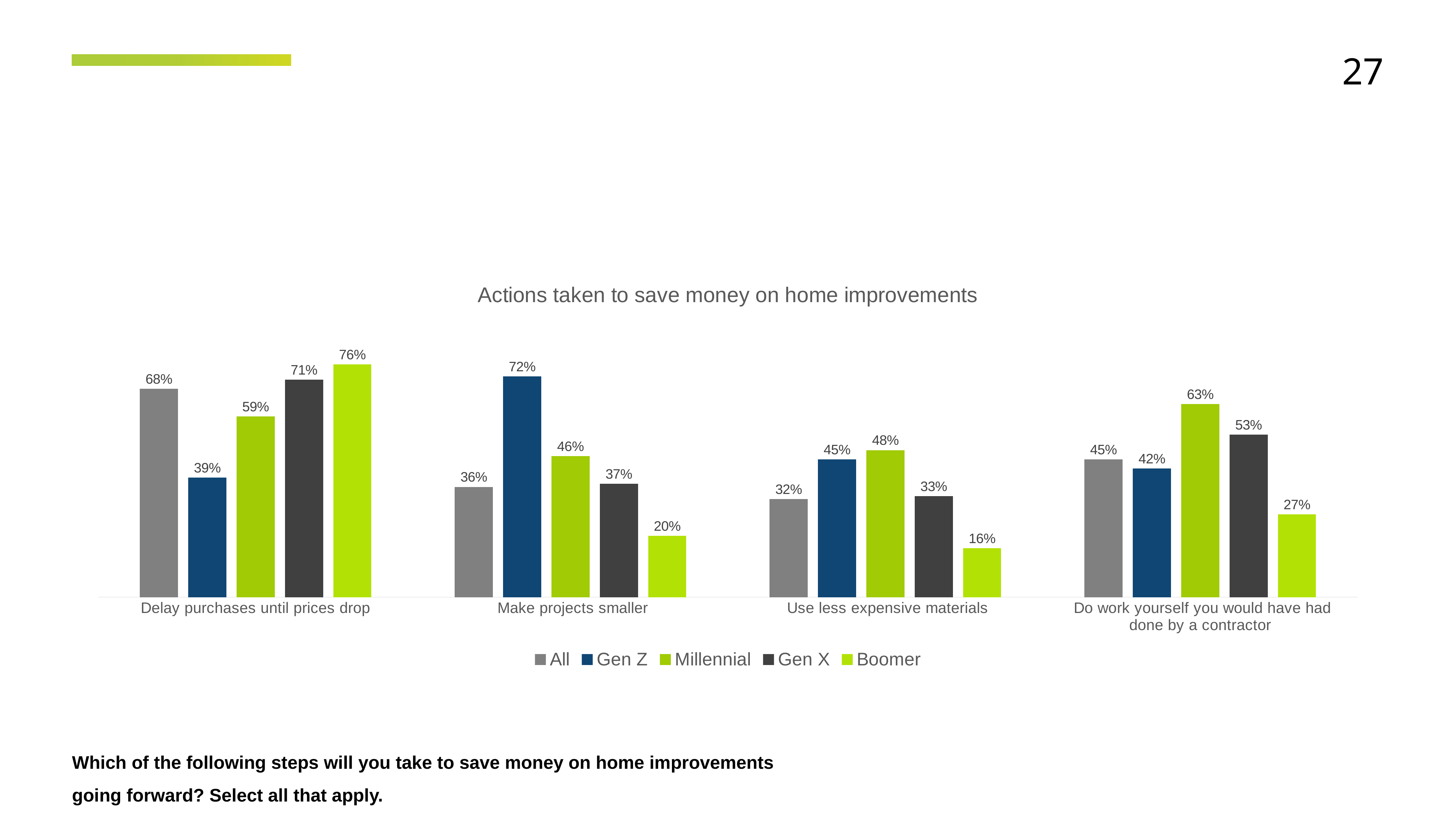
Which series has the lowest value in the 'Use less expensive materials' category? Boomer What is the value for Boomer in the 'Delay purchases until prices drop' category? 76% What kind of chart is shown on the slide? Bar chart How many categories are shown on the x axis? 4 What is the difference between the Boomer and Gen Z values in the 'Delay purchases until prices drop' category? 37% What is the value for Gen X in the 'Do work yourself you would have had done by a contractor' category? 53% What is the value for Gen Z in the 'Make projects smaller' category? 72% What is the value for Millennial in the 'Use less expensive materials' category? 48% What is the title of the chart? Actions taken to save money on home improvements How many series does the legend list? 5 Which series has the highest value in the 'Make projects smaller' category? Gen Z Which is larger in the 'Do work yourself you would have had done by a contractor' category: the Millennial value or the Gen X value? Millennial